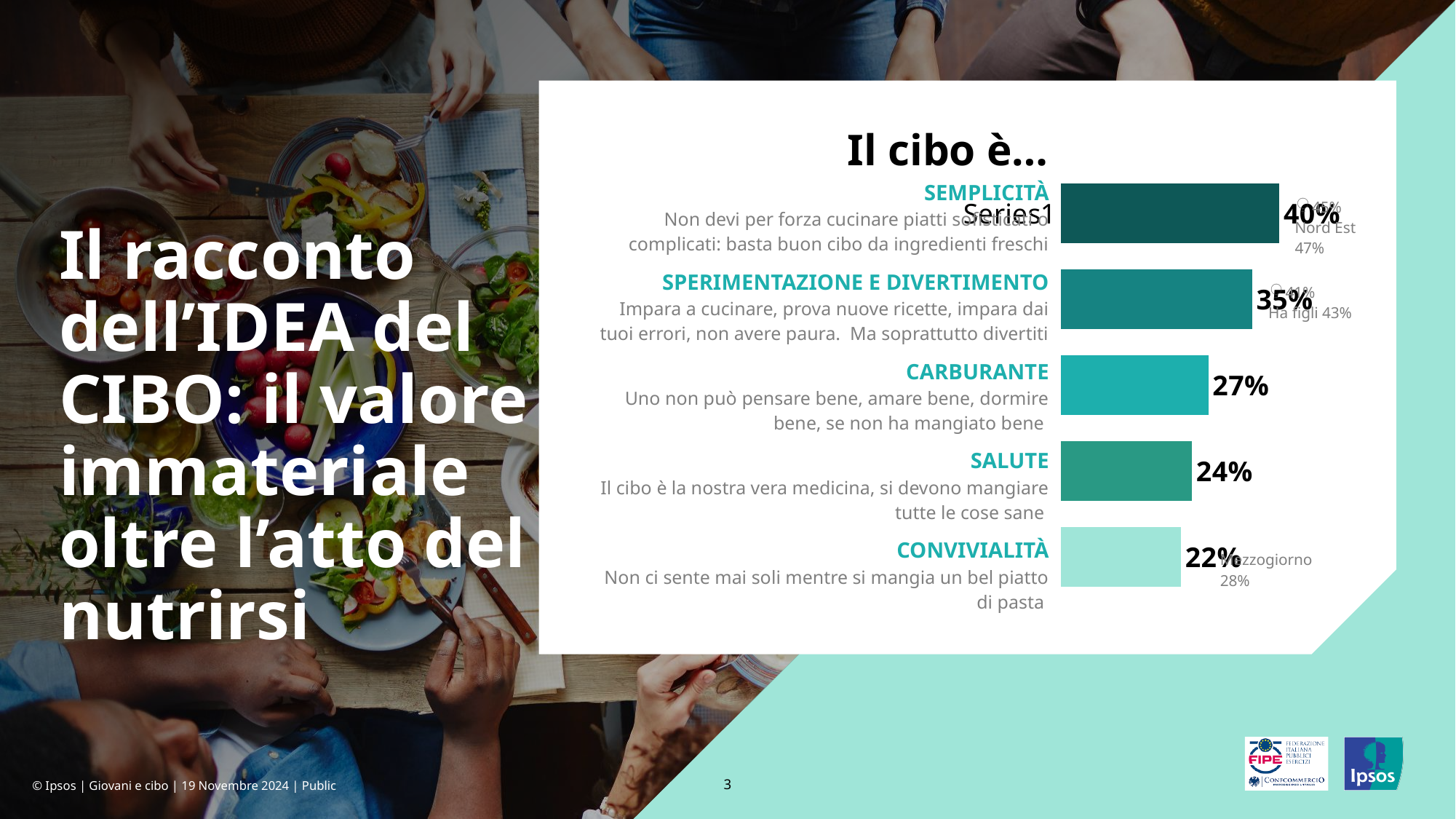
Which category has the lowest value? CONVIVIALITÀ What kind of chart is shown on the slide? bar chart What is the value for SEMPLICITÀ? 40% What is the value for CARBURANTE? 27% What is the value for CONVIVIALITÀ? 22% Which category has the highest value? SEMPLICITÀ What is the value for SPERIMENTAZIONE E DIVERTIMENTO? 35% What is the value for SALUTE? 24% What is the difference between the values for SEMPLICITÀ and CARBURANTE? 13% Which is larger, the value for SALUTE or the value for CONVIVIALITÀ? SALUTE What is the chart's title? Il cibo è… How many categories are shown in the chart? 5